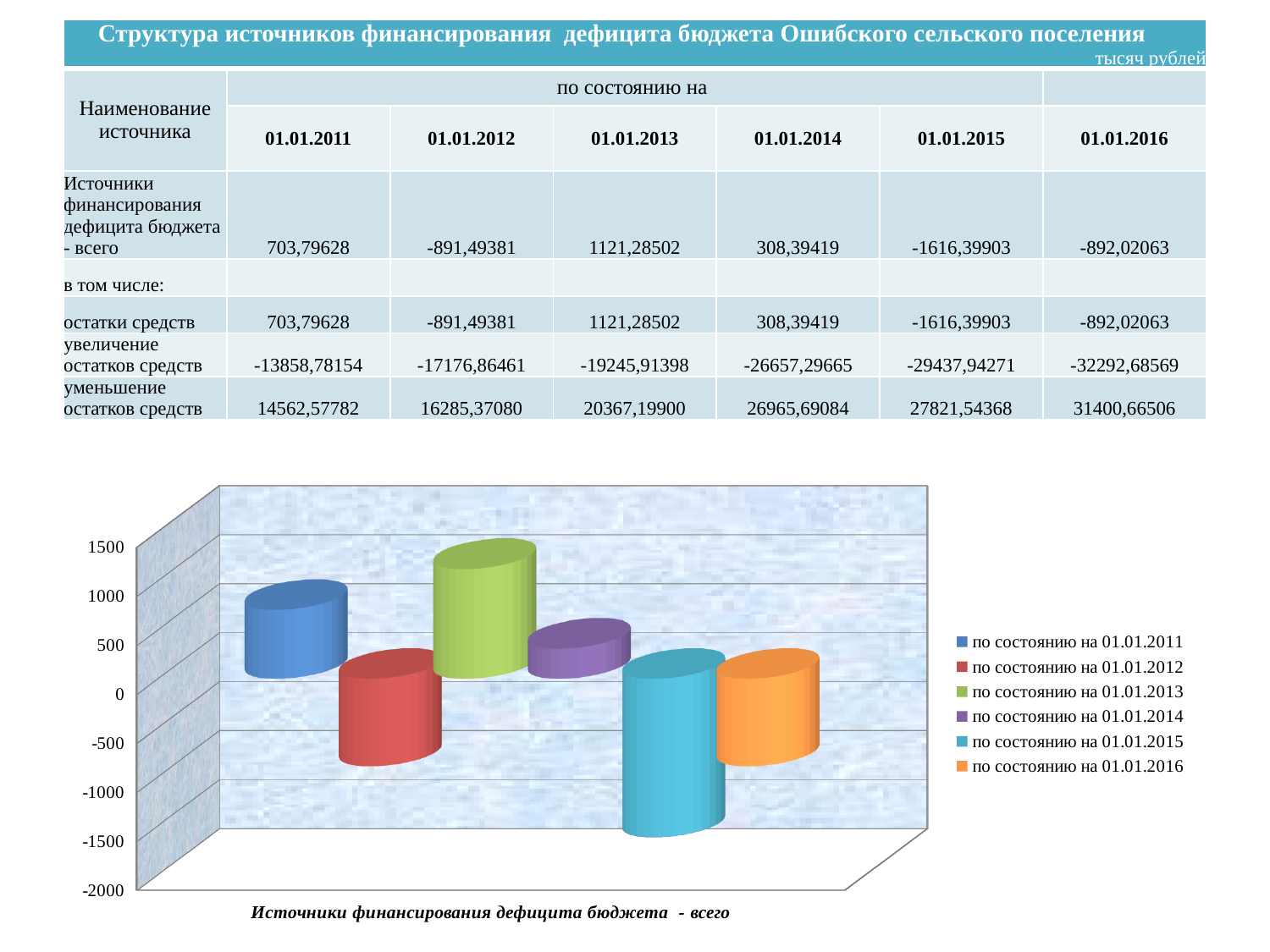
According to the table, what is the value of 'Источники финансирования дефицита бюджета - всего' as of 01.01.2013? 1121,28502 How many series does the chart legend list? 6 How many categories are plotted on the x axis of the chart? 1 Which series has the highest value in the chart? по состоянию на 01.01.2013 What kind of chart is shown on the slide? bar chart According to the table, what is the value of 'Источники финансирования дефицита бюджета - всего' as of 01.01.2015? -1616,39903 Is the value for 'по состоянию на 01.01.2015' in the chart greater or less than -1500? less Which is larger in the chart: the value for 'по состоянию на 01.01.2011' or for 'по состоянию на 01.01.2014'? по состоянию на 01.01.2011 Is the value for 'по состоянию на 01.01.2011' in the chart greater or less than 500? greater Is the value for 'по состоянию на 01.01.2014' in the chart greater or less than 0? greater What is the category label shown beneath the chart? Источники финансирования дефицита бюджета - всего Which series has the lowest value in the chart? по состоянию на 01.01.2015